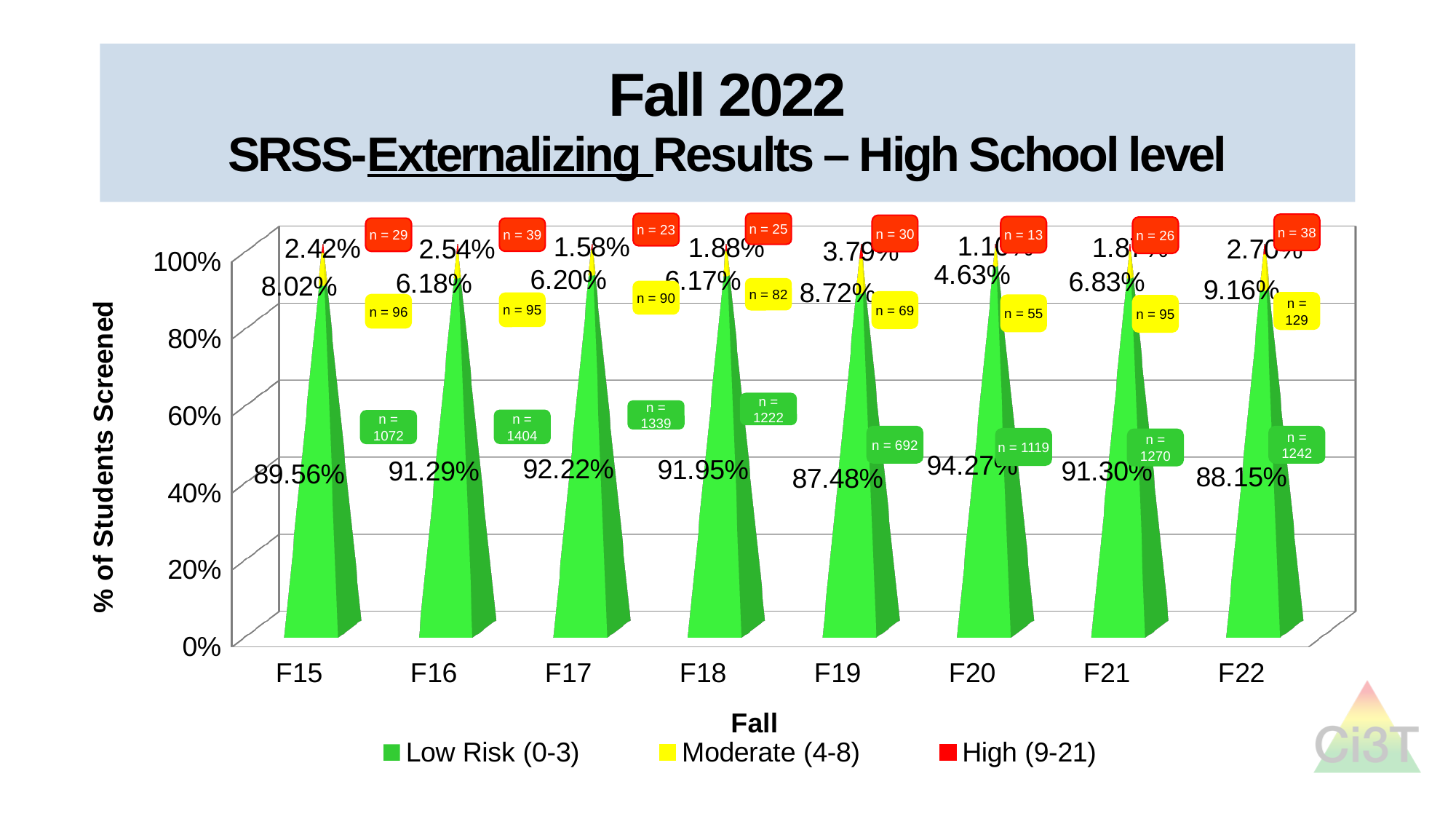
What is the Low Risk (0-3) percentage for F17? 92.22% What is the n value shown for the Low Risk (0-3) group in F16? n = 1404 What is the Moderate (4-8) percentage for F22? 9.16% How many fall screening periods are shown on the x axis? 8 What is the difference between the Moderate (4-8) percentages for F15 and F16? 1.84 percentage points Which is larger, the High (9-21) percentage for F15 or for F16? F16 Which fall has the lowest Low Risk (0-3) percentage? F19 Which fall has the highest Moderate (4-8) percentage? F22 Which fall has the highest Low Risk (0-3) percentage? F20 What is the High (9-21) percentage for F19? 3.79% How many series does the legend list? 3 What kind of chart is shown on the slide? Stacked bar chart